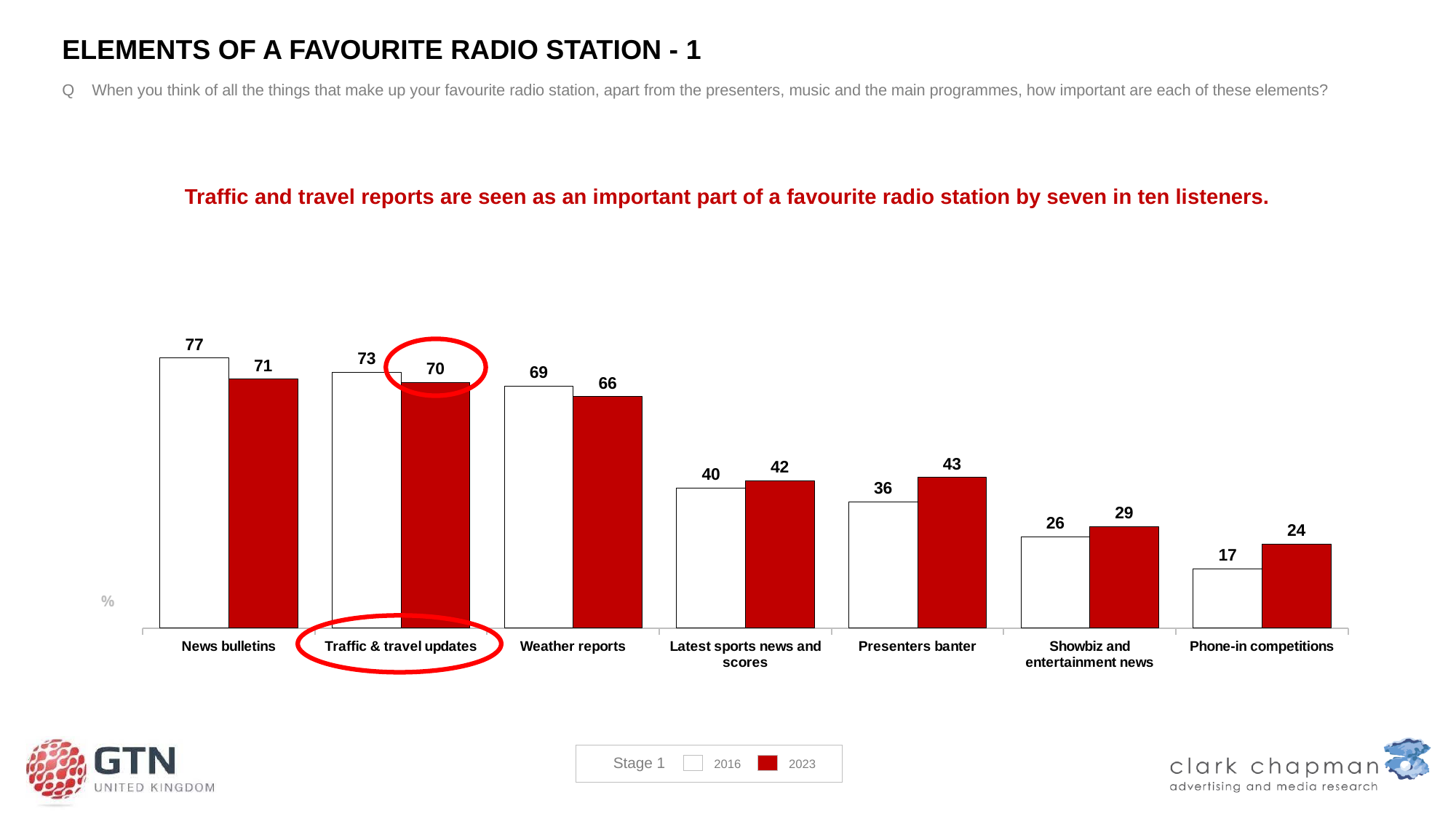
What is the difference between the 2023 values for Weather reports and Latest sports news and scores? 24 How many series does the legend list? 2 How many categories are shown on the x axis? 7 What is the 2023 value for Phone-in competitions? 24 What is the 2016 value for Presenters banter? 36 Which is larger for Presenters banter: the 2016 value or the 2023 value? 2023 What is the 2023 value for Traffic & travel updates? 70 Which colour represents the 2023 series in the chart? Red Which category has the lowest 2016 value? Phone-in competitions What is the difference between the 2016 and 2023 values for News bulletins? 6 What kind of chart is shown on the slide? Bar chart Which category has the highest 2023 value? News bulletins